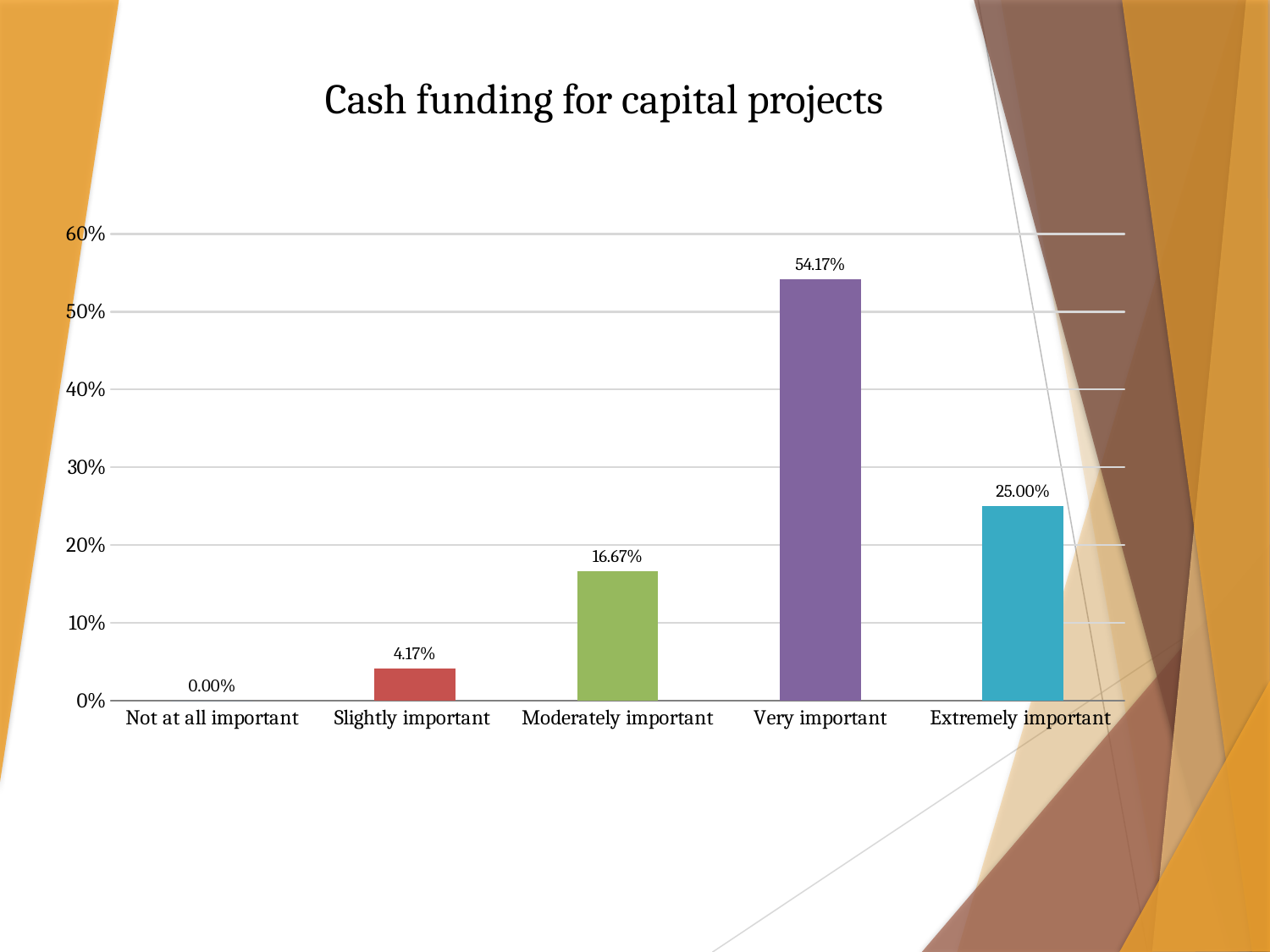
Which category has the lowest value? Not at all important What is the title of the chart? Cash funding for capital projects How many categories are shown on the x axis? 5 What kind of chart is shown on the slide? bar chart What is the value for Slightly important? 4.17% Which is larger, the value for Moderately important or the value for Extremely important? Extremely important Which category has the highest value? Very important What is the value for Extremely important? 25.00% What is the value for Very important? 54.17% What is the difference between the values for Very important and Extremely important? 29.17% Is the value for Very important greater or less than 50%? greater What is the value for Moderately important? 16.67%